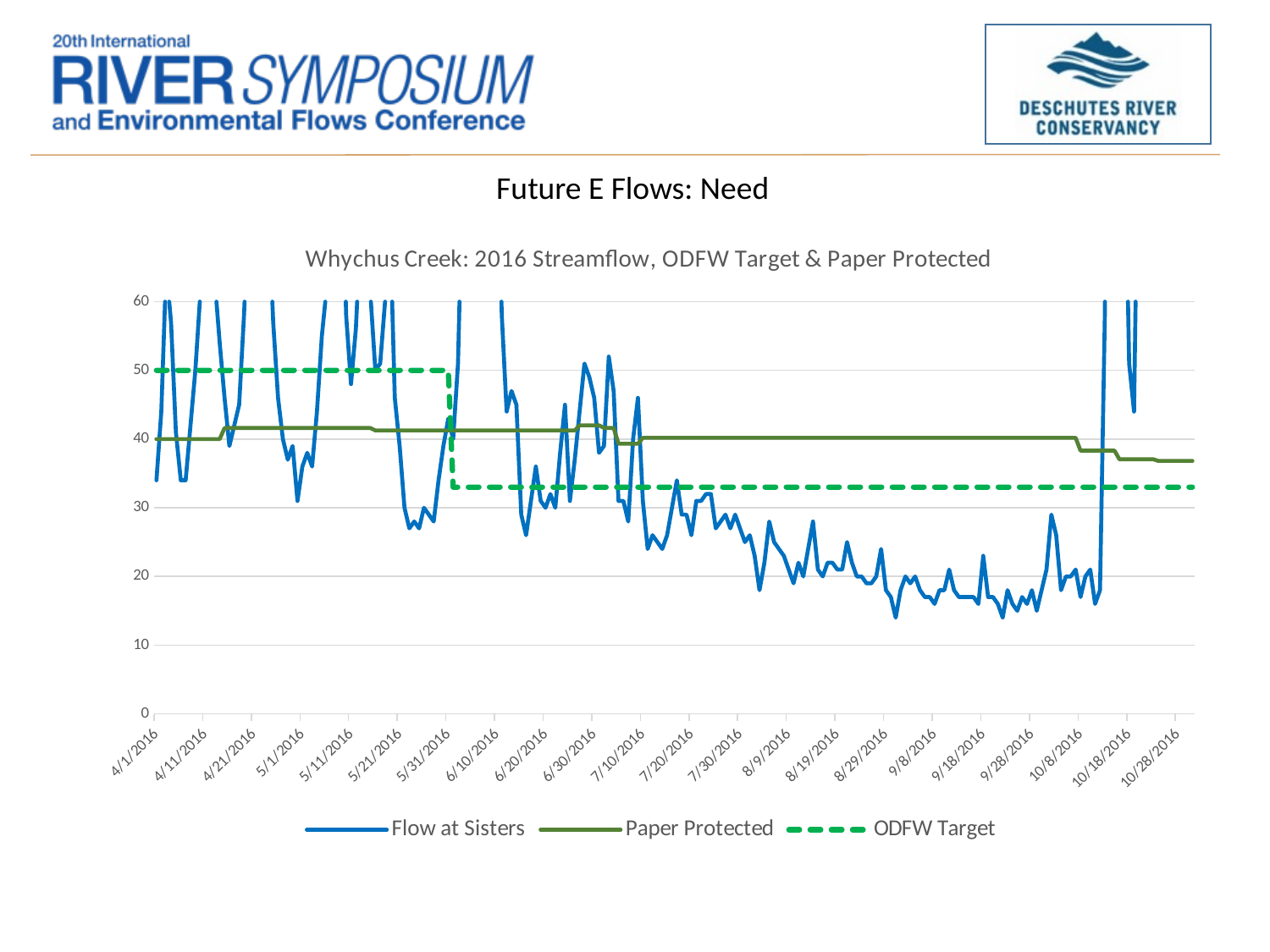
Which series is drawn with a dashed line? ODFW Target Does the ODFW Target series rise or fall from 4/1/2016 to 10/28/2016? fall On 5/1/2016, which is larger: ODFW Target or Paper Protected? ODFW Target Is the ODFW Target value on 8/9/2016 greater or less than 40? less Is the Paper Protected value on 7/20/2016 greater or less than 30? greater What is the title of the chart? Whychus Creek: 2016 Streamflow, ODFW Target & Paper Protected On 8/29/2016, which is larger: Paper Protected or Flow at Sisters? Paper Protected Is the Flow at Sisters value on 9/8/2016 greater or less than 30? less How many date labels are shown on the x axis? 22 What kind of chart is shown on the slide? line chart How many series does the legend list? 3